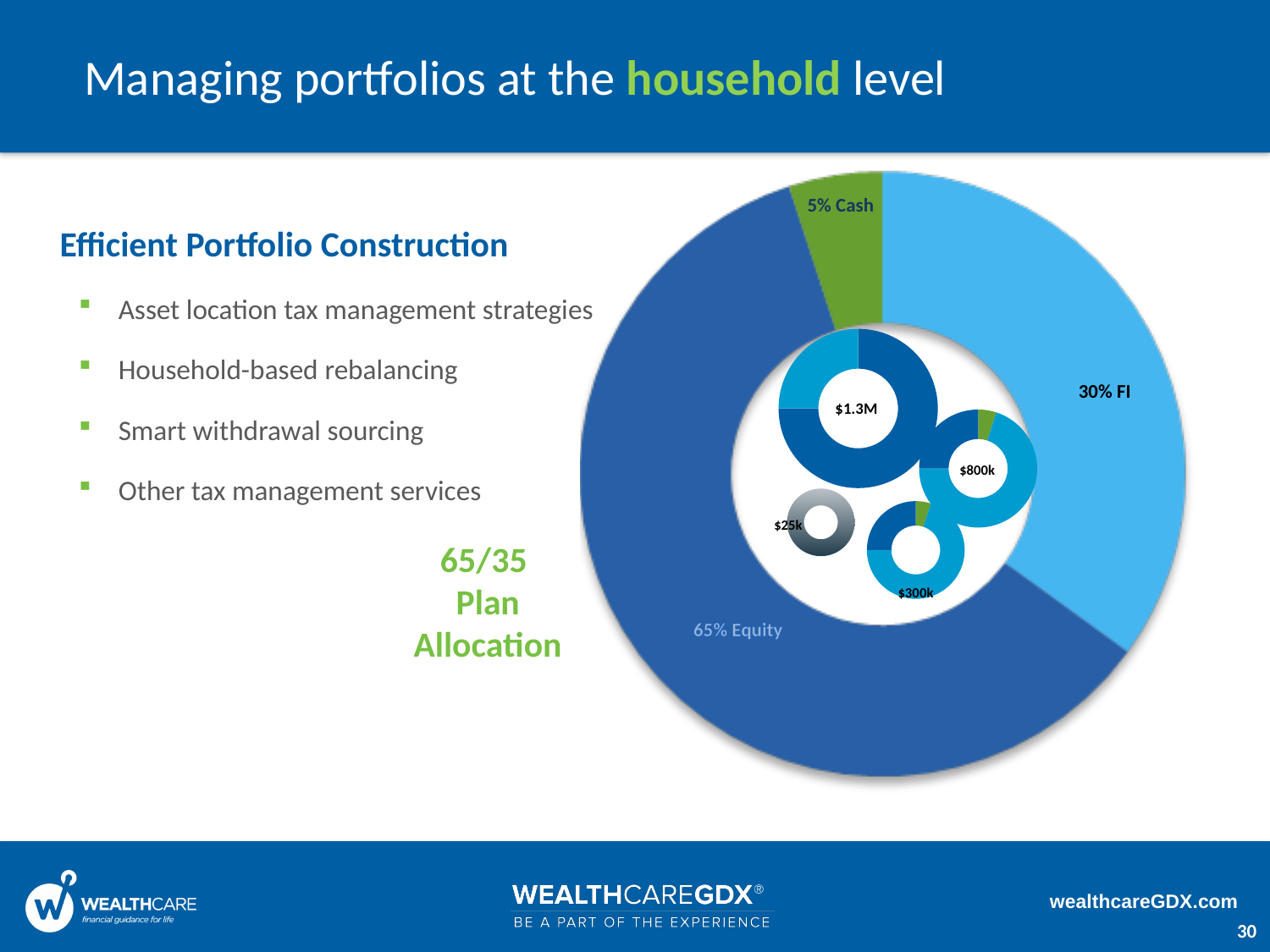
How many small donut charts are shown inside the large donut chart? 4 How many slices does the large donut chart have? 3 What kind of chart is the large chart on the right of the slide? Pie (donut) chart In the large donut chart, what share of the plan allocation is FI? 30% In the large donut chart, which is larger, the FI slice or the Cash slice? FI In the large donut chart, what do the Equity, FI and Cash shares add up to? 100% In the large donut chart, by how many percentage points does the Equity share exceed the FI share? 35 percentage points In the large donut chart, which category has the largest slice? Equity In the large donut chart, which category has the smallest slice? Cash In the large donut chart, what share of the plan allocation is Cash? 5% In the large donut chart, what share of the plan allocation is Equity? 65% What value is labelled on the largest of the small donut charts inside the large donut? $1.3M